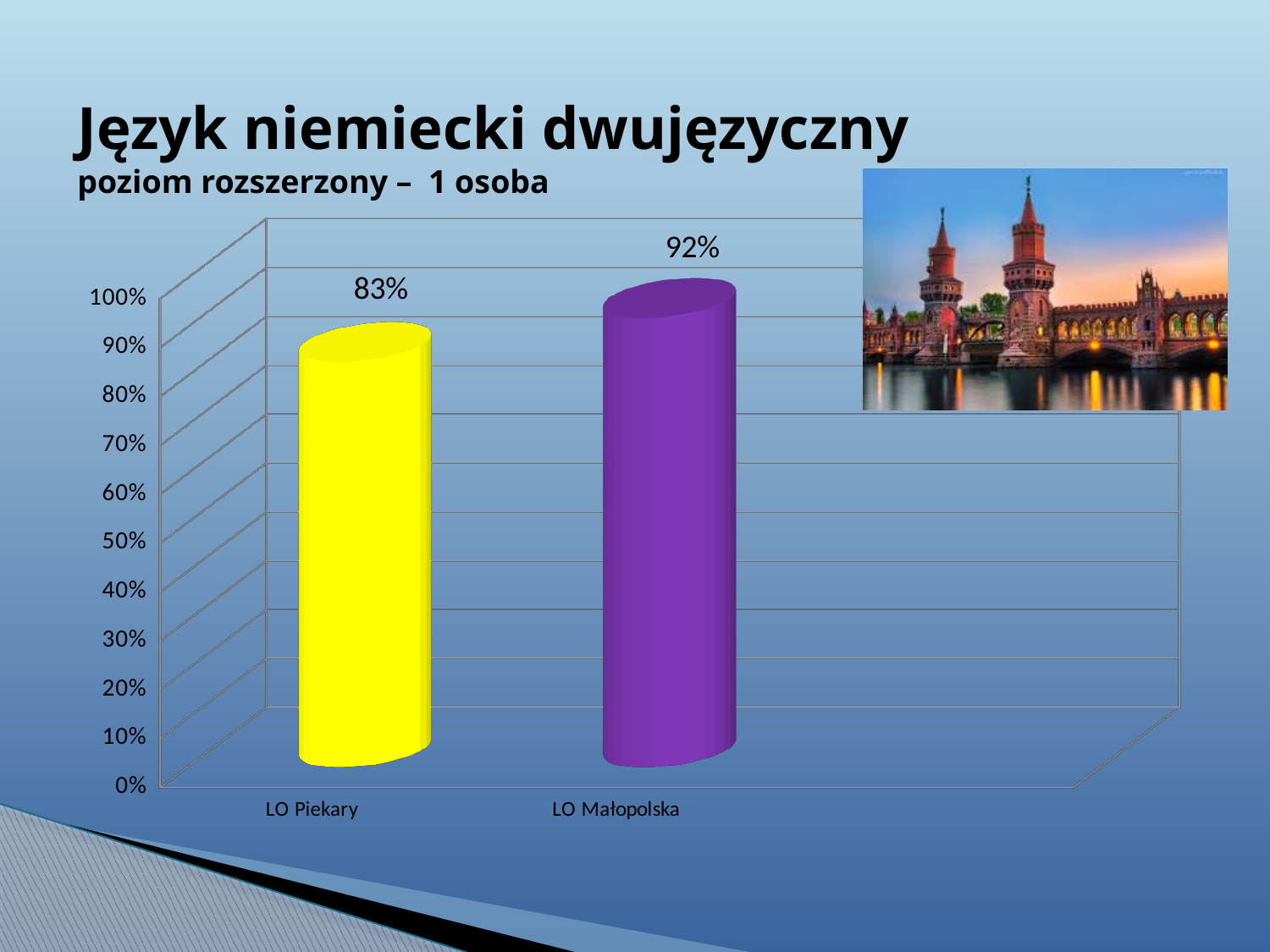
Which is larger, the value for LO Piekary or the value for LO Małopolska? LO Małopolska How many categories are shown on the chart? 2 What is the value for LO Małopolska? 92% What is the difference between the values for LO Małopolska and LO Piekary? 9% Which category has the lowest value? LO Piekary What colour is the bar for LO Piekary? yellow Is the value for LO Małopolska greater or less than 90%? greater Is the value for LO Piekary greater or less than 90%? less What is the value for LO Piekary? 83% What colour is the bar for LO Małopolska? purple Which category has the highest value? LO Małopolska What kind of chart is shown on the slide? bar chart